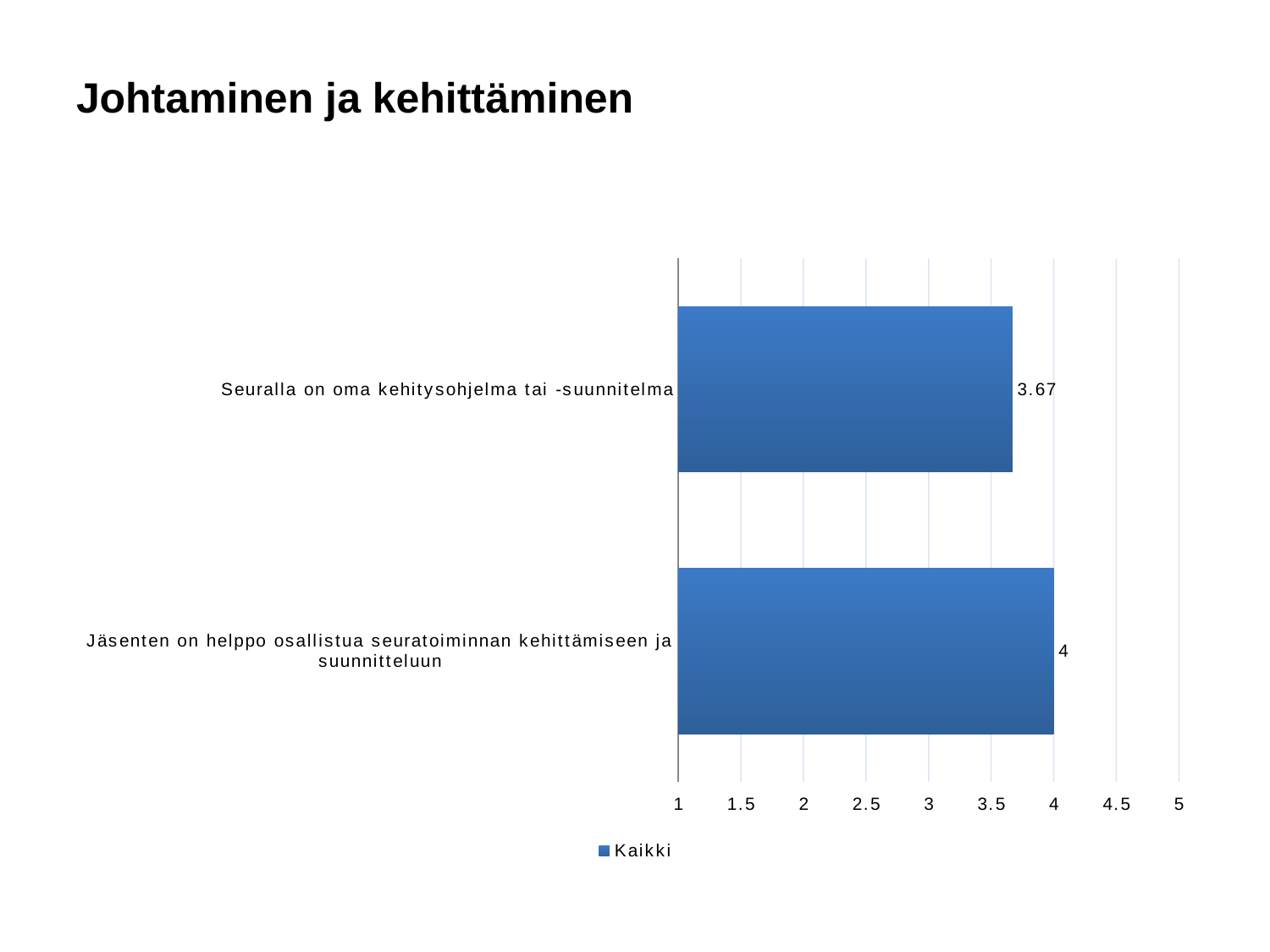
Which category has the lowest value? Seuralla on oma kehitysohjelma tai -suunnitelma How many series does the legend list? 1 What is the value for "Jäsenten on helppo osallistua seuratoiminnan kehittämiseen ja suunnitteluun"? 4 Is the value for "Jäsenten on helppo osallistua seuratoiminnan kehittämiseen ja suunnitteluun" greater or less than 4.5? less What is the difference between the values for "Jäsenten on helppo osallistua seuratoiminnan kehittämiseen ja suunnitteluun" and "Seuralla on oma kehitysohjelma tai -suunnitelma"? 0.33 What is the value for "Seuralla on oma kehitysohjelma tai -suunnitelma"? 3.67 How many categories are shown in the chart? 2 Is the value for "Seuralla on oma kehitysohjelma tai -suunnitelma" greater or less than 3? greater What kind of chart is shown on the slide? Bar chart What is the name of the series shown in the legend? Kaikki Which is larger: the value for "Seuralla on oma kehitysohjelma tai -suunnitelma" or for "Jäsenten on helppo osallistua seuratoiminnan kehittämiseen ja suunnitteluun"? Jäsenten on helppo osallistua seuratoiminnan kehittämiseen ja suunnitteluun Which category has the highest value? Jäsenten on helppo osallistua seuratoiminnan kehittämiseen ja suunnitteluun